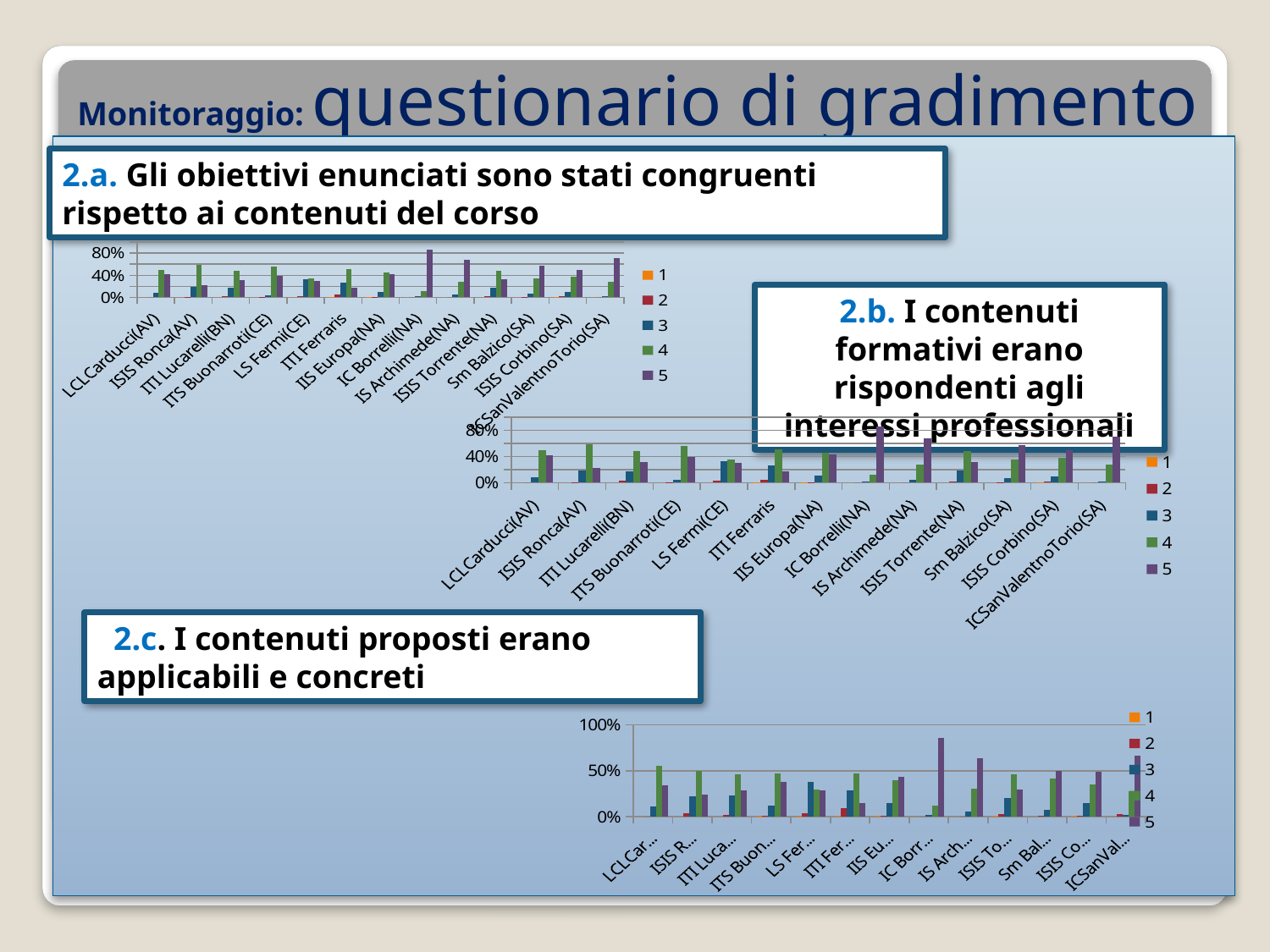
In the 2.c chart (bottom-right), is the value of series 5 for LCL Carducci(AV) greater or less than 50%? less How many school categories are shown on the x axis of the 2.b chart (middle-right)? 13 What are the legend entries of the 2.a chart (top-left)? 1, 2, 3, 4, 5 In the 2.b chart (middle-right), which category has the tallest bar for series 5? IC Borrelli(NA) In the 2.c chart (bottom-right), which is larger for LCL Carducci(AV): series 4 or series 5? series 4 How many series does the legend of the 2.c chart (bottom-right) list? 5 What is the highest value shown on the y axis of the 2.c chart (bottom-right)? 100% In the 2.a chart (top-left), is the value of series 5 for IC Borrelli(NA) greater or less than 40%? greater In the 2.c chart (bottom-right), is the value of series 5 for IC Borrelli(NA) greater or less than 50%? greater In the 2.c chart (bottom-right), which category has the tallest bar for series 5? IC Borrelli(NA) What kind of chart is used for question 2.a (top-left chart)? bar chart